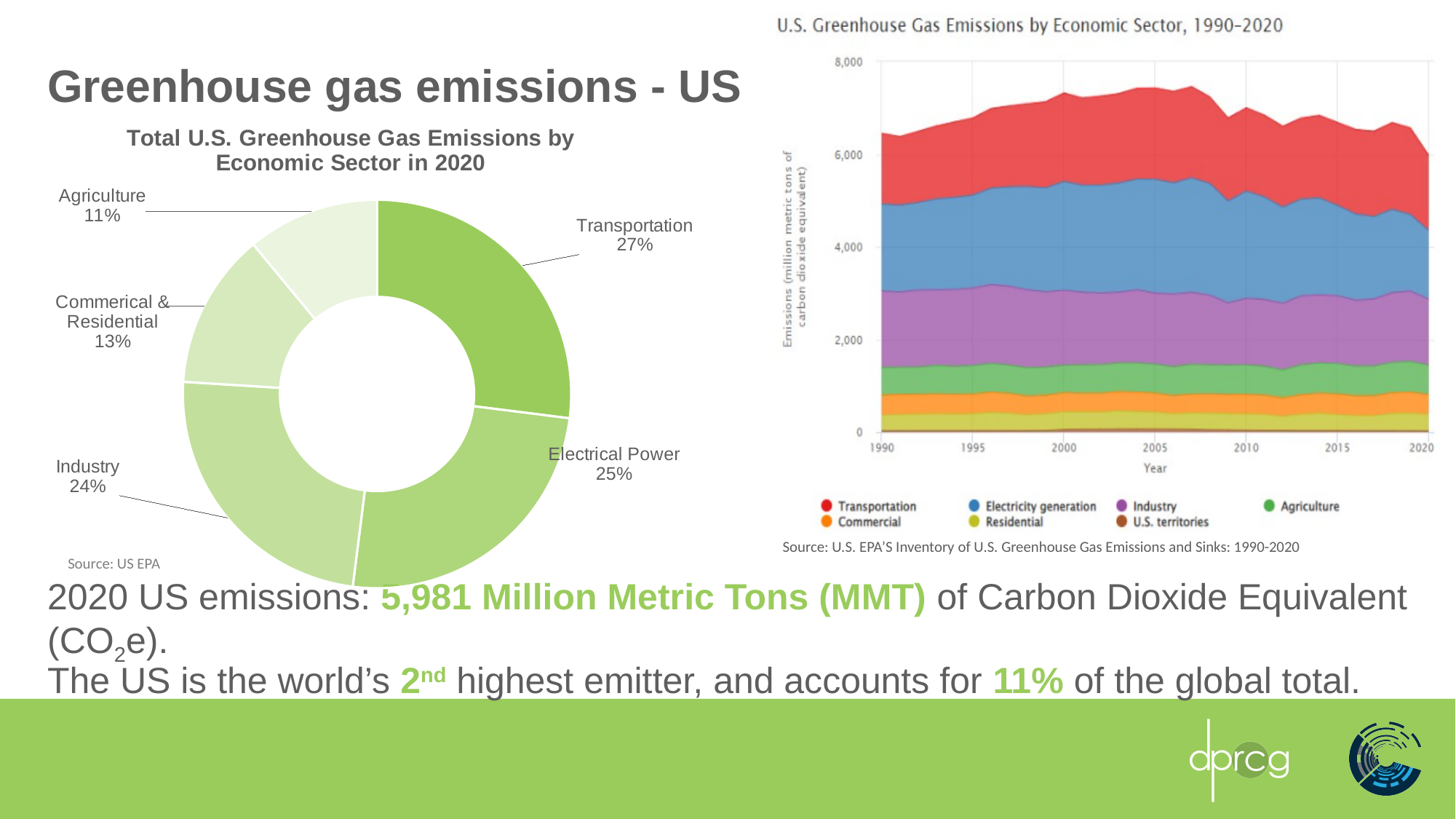
In the chart 'U.S. Greenhouse Gas Emissions by Economic Sector, 1990-2020', do total emissions rise or fall between 2007 and 2020? fall In the donut chart on the left, which sector has the largest share? Transportation How many series does the legend of the chart 'U.S. Greenhouse Gas Emissions by Economic Sector, 1990-2020' list? 7 In the donut chart on the left, what is the share for Agriculture? 11% In the donut chart on the left, which sector has the smallest share? Agriculture In the donut chart on the left, what is the share for Electrical Power? 25% In the chart 'U.S. Greenhouse Gas Emissions by Economic Sector, 1990-2020', is the total emissions value in 2020 greater or less than 7,000? less How many sectors are shown in the donut chart on the left? 5 In the donut chart 'Total U.S. Greenhouse Gas Emissions by Economic Sector in 2020', what share does Transportation account for? 27% What kind of chart is the chart on the left of the slide? Donut (pie) chart In the donut chart on the left, what is the difference in percentage points between Industry and Commercial & Residential? 11 In the donut chart on the left, which is larger: Electrical Power or Industry? Electrical Power